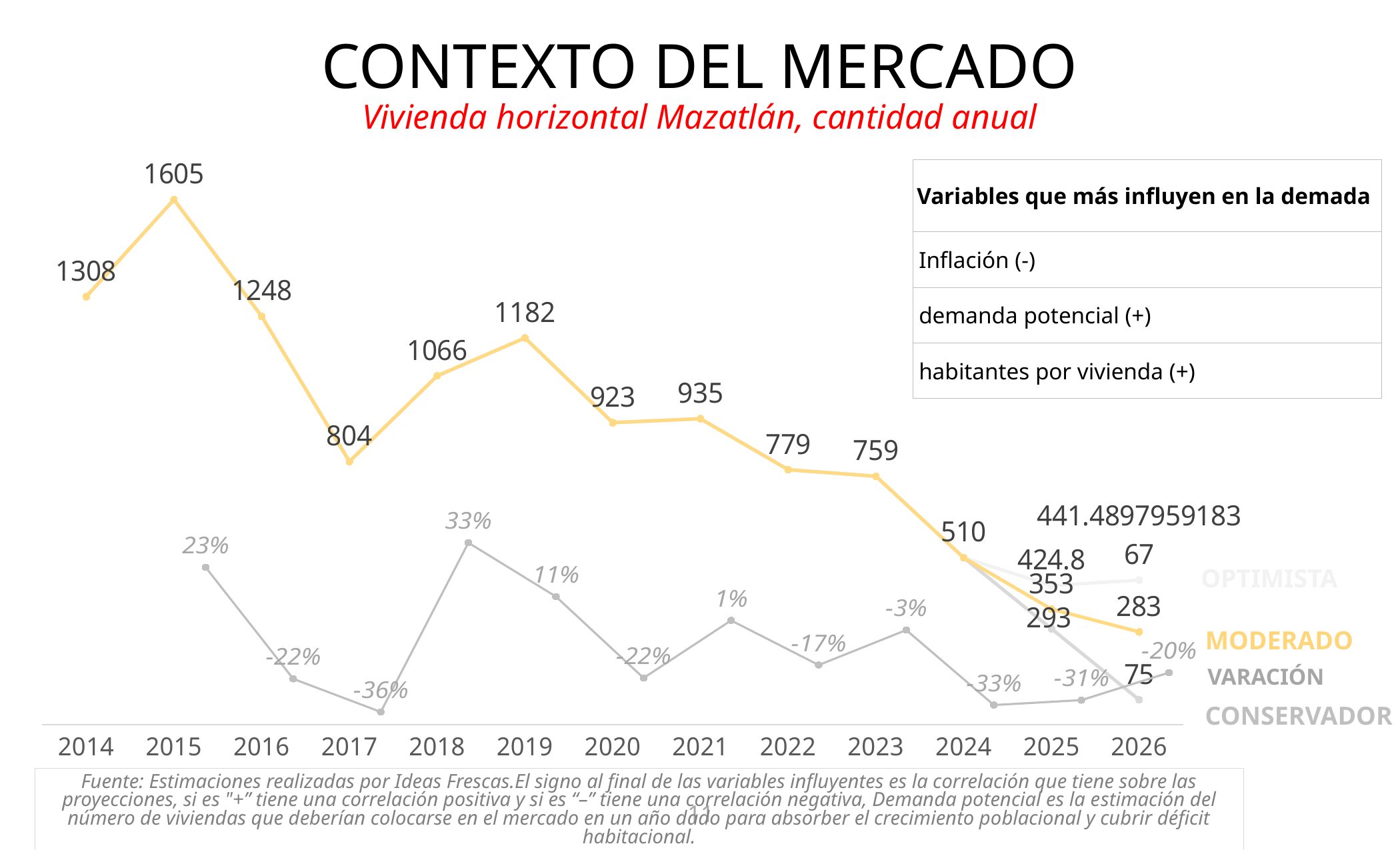
In which year does the MODERADO series reach its highest value? 2015 How many years are shown on the x axis? 13 What is the VARIACIÓN value for 2017? -36% What kind of chart is shown on the slide? Line chart What is the difference between the MODERADO values for 2015 and 2016? 357 In which year does the MODERADO series reach its lowest value? 2026 What is the MODERADO value for 2017? 804 Does the MODERADO series rise or fall from 2019 to 2026? Fall What is the VARIACIÓN value for 2018? 33% What is the MODERADO value for 2015? 1605 Which is larger, the MODERADO value for 2020 or for 2021? 2021 What is the subtitle of the chart shown in red? Vivienda horizontal Mazatlán, cantidad anual